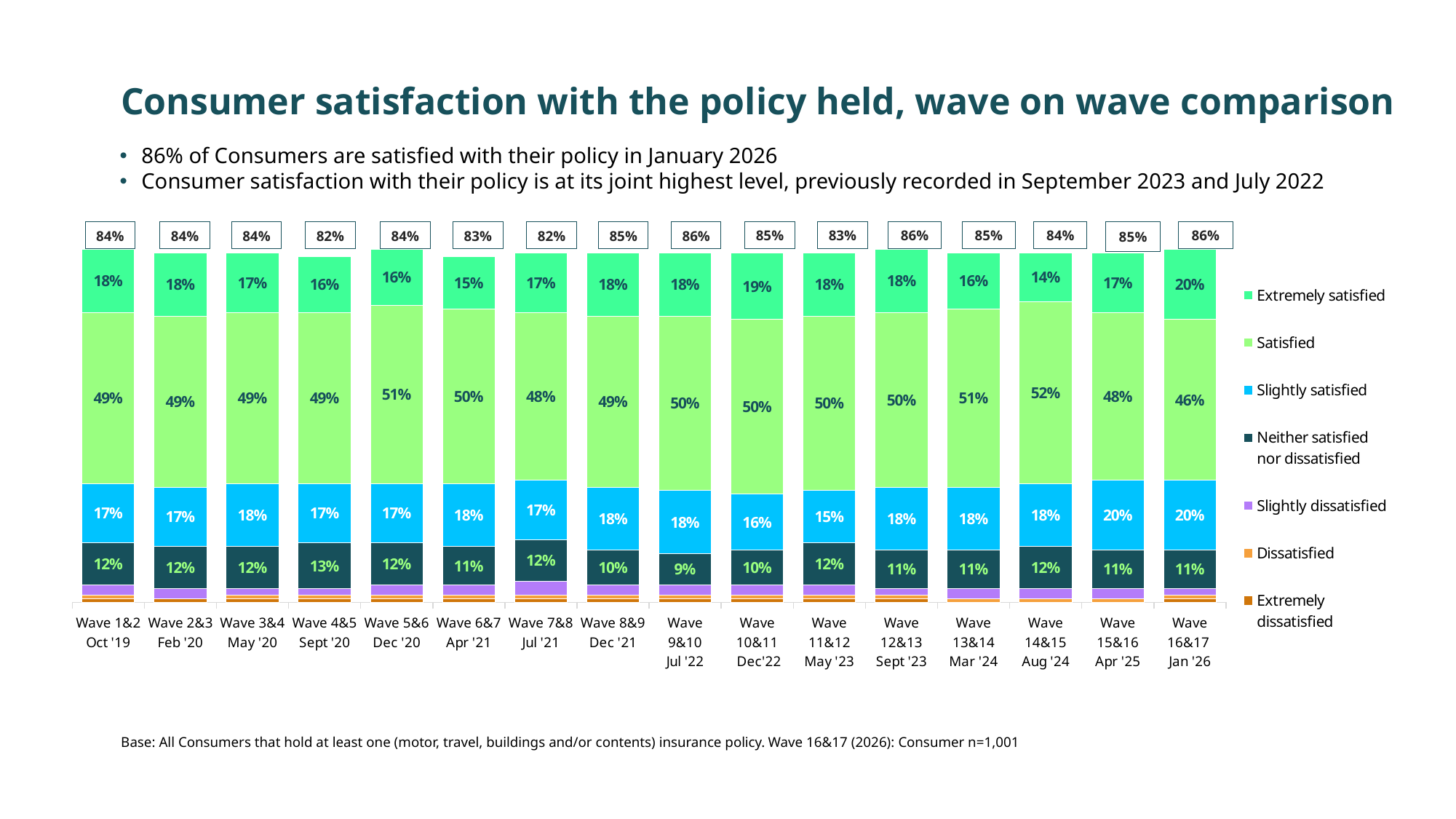
How many waves are shown on the x axis? 16 What is the Neither satisfied nor dissatisfied value for Wave 9&10 Jul '22? 9% What is the combined share of Extremely satisfied and Satisfied for Wave 16&17 Jan '26? 66% Which wave has the lowest Extremely satisfied value? Wave 14&15 Aug '24 What kind of chart is shown on the slide? Stacked bar chart What is the Slightly satisfied value for Wave 10&11 Dec '22? 16% What is the Satisfied value for Wave 14&15 Aug '24? 52% How many series does the legend list? 7 What percentage of consumers were Extremely satisfied in Wave 16&17 Jan '26? 20% What is the difference between the Extremely satisfied values for Wave 16&17 Jan '26 and Wave 14&15 Aug '24? 6 percentage points Which wave has the highest Satisfied value? Wave 14&15 Aug '24 Which has the larger Slightly satisfied value, Wave 15&16 Apr '25 or Wave 11&12 May '23? Wave 15&16 Apr '25